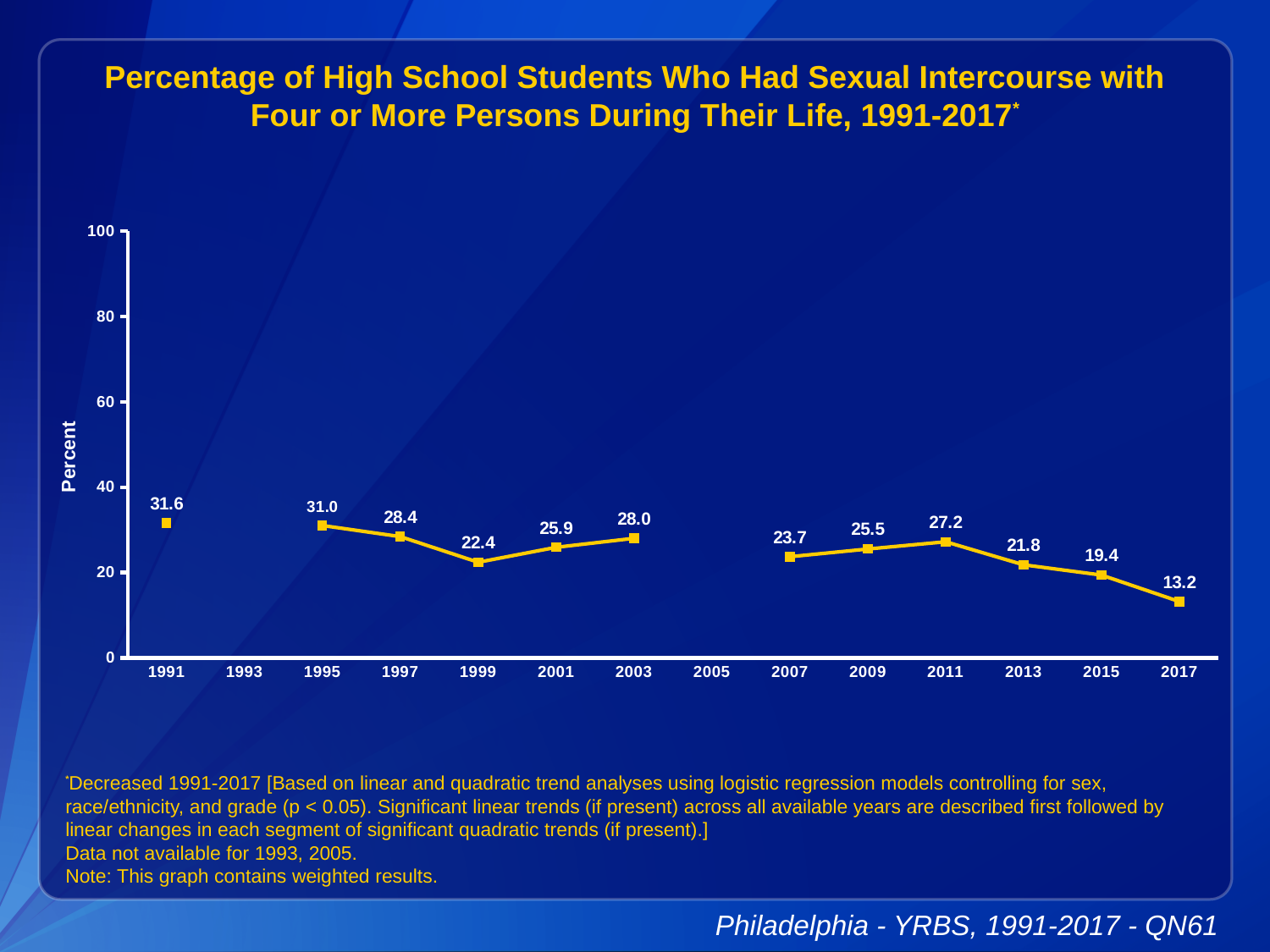
What kind of chart is shown on the slide? line chart Which is larger, the value for 2003 or the value for 2007? 2003 Which year has the highest value? 1991 What is the value for 2017? 13.2 What is the value for 1991? 31.6 How many data points are plotted on the chart? 12 What is the label on the y axis? Percent Is the value for 2011 greater or less than 20? greater Which year has the lowest value? 2017 What is the difference between the values for 1991 and 2017? 18.4 What is the value for 1999? 22.4 Do the values generally rise or fall from 1991 to 2017? fall